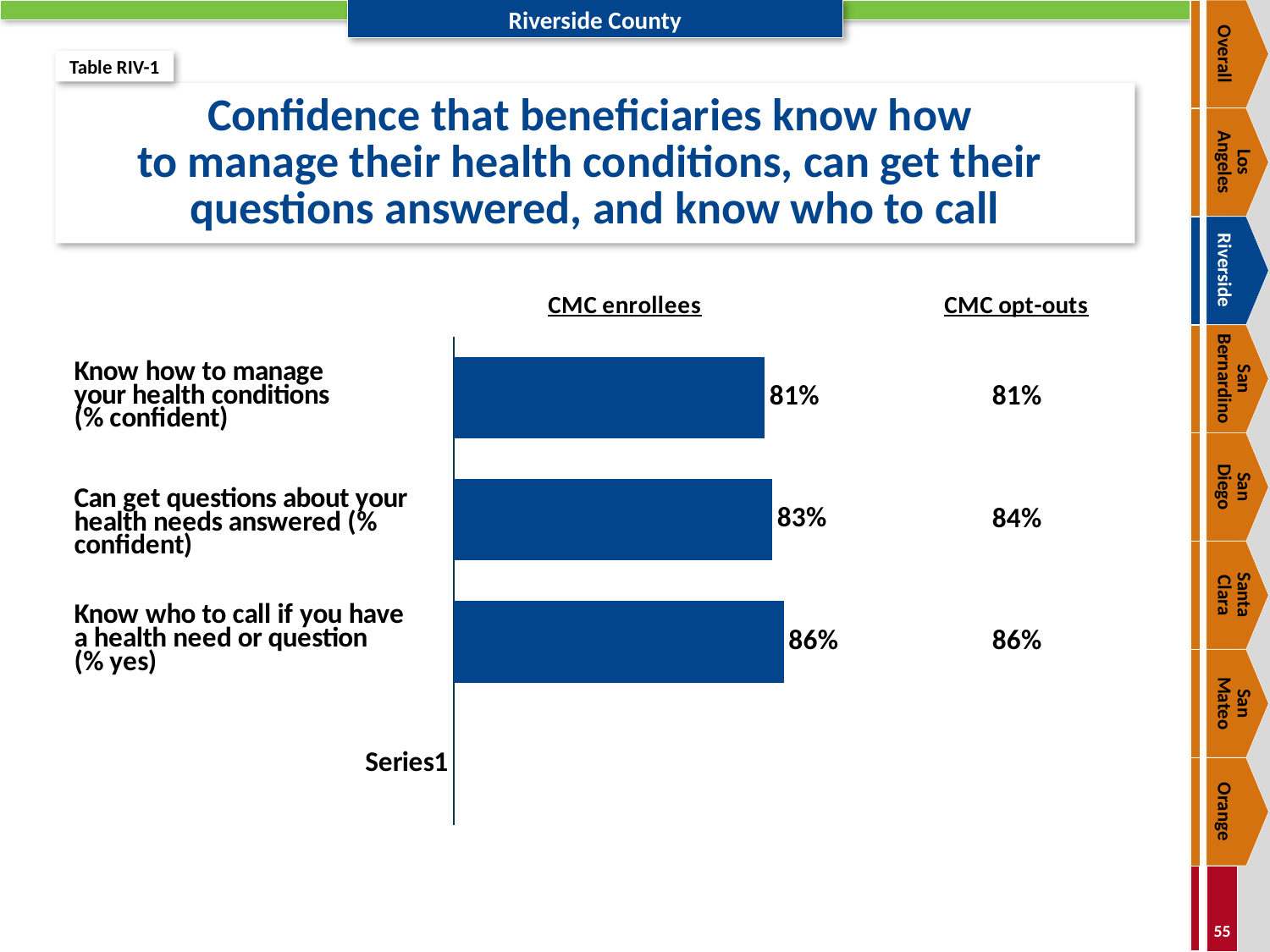
What is the CMC opt-outs value for "Can get questions about your health needs answered"? 84% What is the CMC enrollees value for "Know how to manage your health conditions"? 81% Which item has the lowest CMC enrollees bar? Know how to manage your health conditions How many bars are plotted in the chart? 3 For "Can get questions about your health needs answered", what is the difference between the CMC opt-outs and CMC enrollees values? 1 percentage point What is the title of the chart? Confidence that beneficiaries know how to manage their health conditions, can get their questions answered, and know who to call What is the CMC enrollees value for "Can get questions about your health needs answered"? 83% What is the CMC enrollees value for "Know who to call if you have a health need or question"? 86% What is the difference between the CMC enrollees values for "Know who to call if you have a health need or question" and "Know how to manage your health conditions"? 5 percentage points Which CMC enrollees bar is larger: "Know how to manage your health conditions" or "Can get questions about your health needs answered"? Can get questions about your health needs answered What kind of chart is shown on the slide? Bar chart Which item has the highest CMC enrollees bar? Know who to call if you have a health need or question